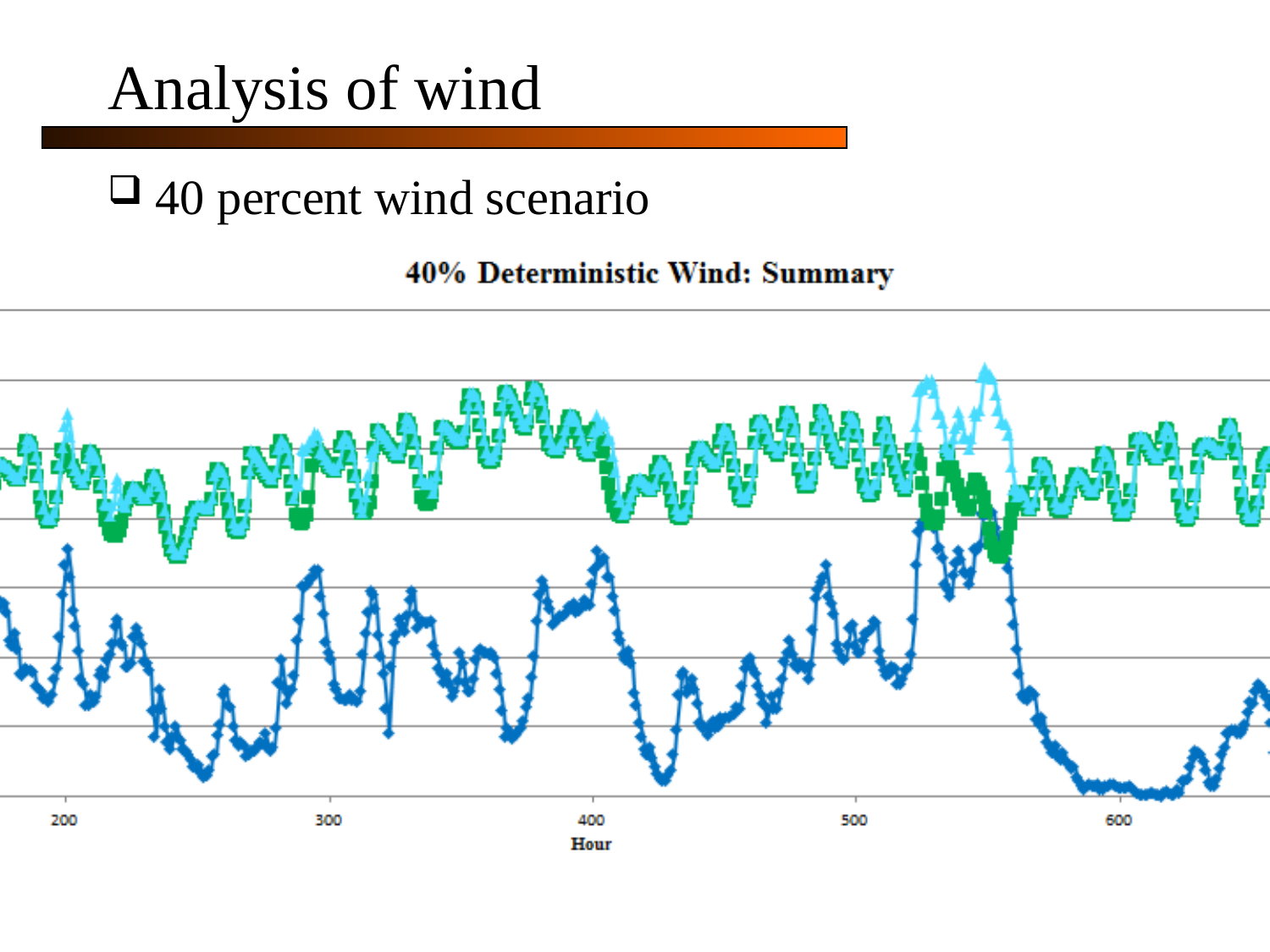
What kind of chart is shown on the slide? line chart Does the dark blue diamond line rise or fall between hour 620 and hour 660? rise How many lines (series) are plotted on the chart? 3 What is the smallest hour value labelled on the x axis? 200 What is the label of the x axis of the chart? Hour Which line is plotted lowest on the chart: the dark blue diamond line or the green square line? the dark blue diamond line Does the dark blue diamond line rise or fall between hour 560 and hour 620? fall Is the dark blue diamond line higher at hour 400 or at hour 600? hour 400 What is the title of the chart? 40% Deterministic Wind: Summary What is the largest hour value labelled on the x axis? 600